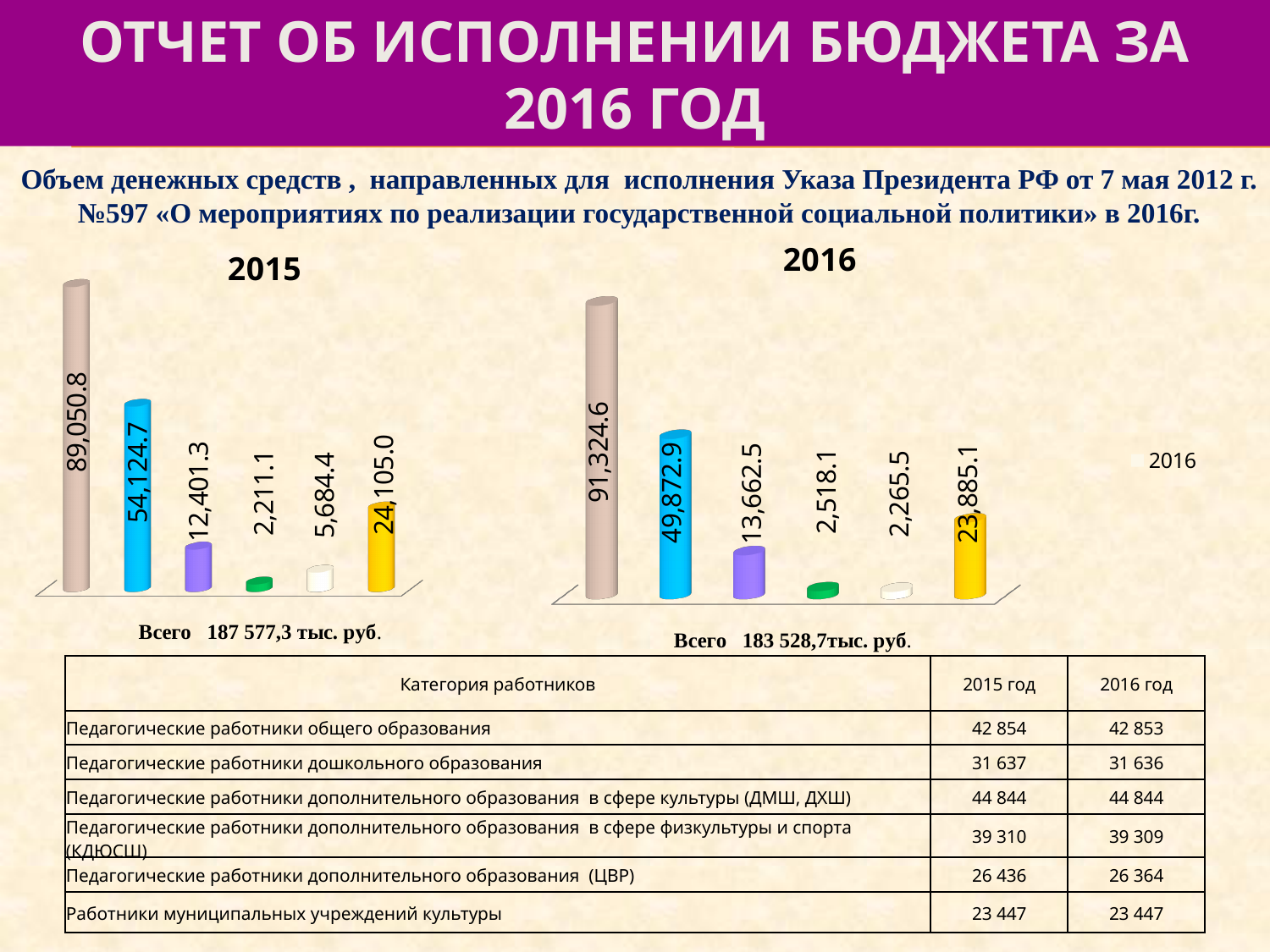
In the chart titled 2015, what is the difference between the first bar (89,050.8) and the second bar (54,124.7)? 34,926.1 In the chart titled 2015, what is the lowest value shown? 2,211.1 In the chart titled 2015, what is the value of the purple bar (the third bar)? 12,401.3 In the chart titled 2015, what is the value of the tallest (first, beige) bar? 89,050.8 In the chart titled 2015, which is larger: the green bar or the white bar? the white bar What type of chart is the chart titled 2015? bar chart In the chart titled 2016, what is the lowest value shown? 2,265.5 In the chart titled 2016, what is the value of the yellow bar (the last bar)? 23,885.1 In the chart titled 2016, what is the value of the blue bar (the second bar)? 49,872.9 In the chart titled 2016, what is the difference between the yellow bar (23,885.1) and the purple bar (13,662.5)? 10,222.6 In the chart titled 2016, what is the highest value shown? 91,324.6 How many bars are plotted in the chart titled 2016? 6